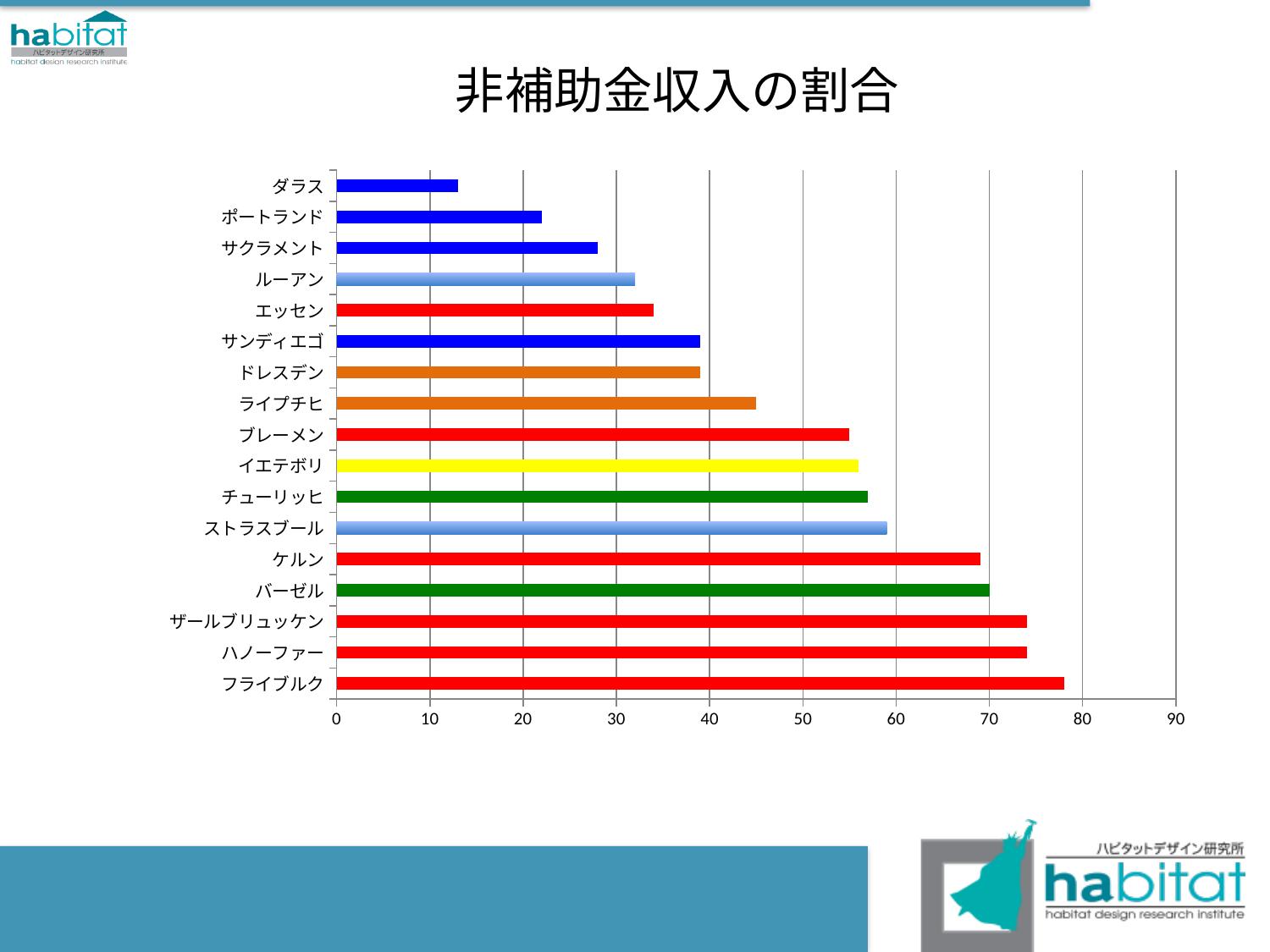
Which city has the lowest value? ダラス Is the value for フライブルク greater or less than 70? greater Which city has the highest value? フライブルク Is the value for ライプチヒ greater or less than 40? greater Is the value for ダラス greater or less than 20? less Which has the larger value, ライプチヒ or ドレスデン? ライプチヒ What kind of chart is shown on the slide? bar chart Which has the larger value, ケルン or ダラス? ケルン What is the title of the chart? 非補助金収入の割合 How many cities are listed on the chart? 17